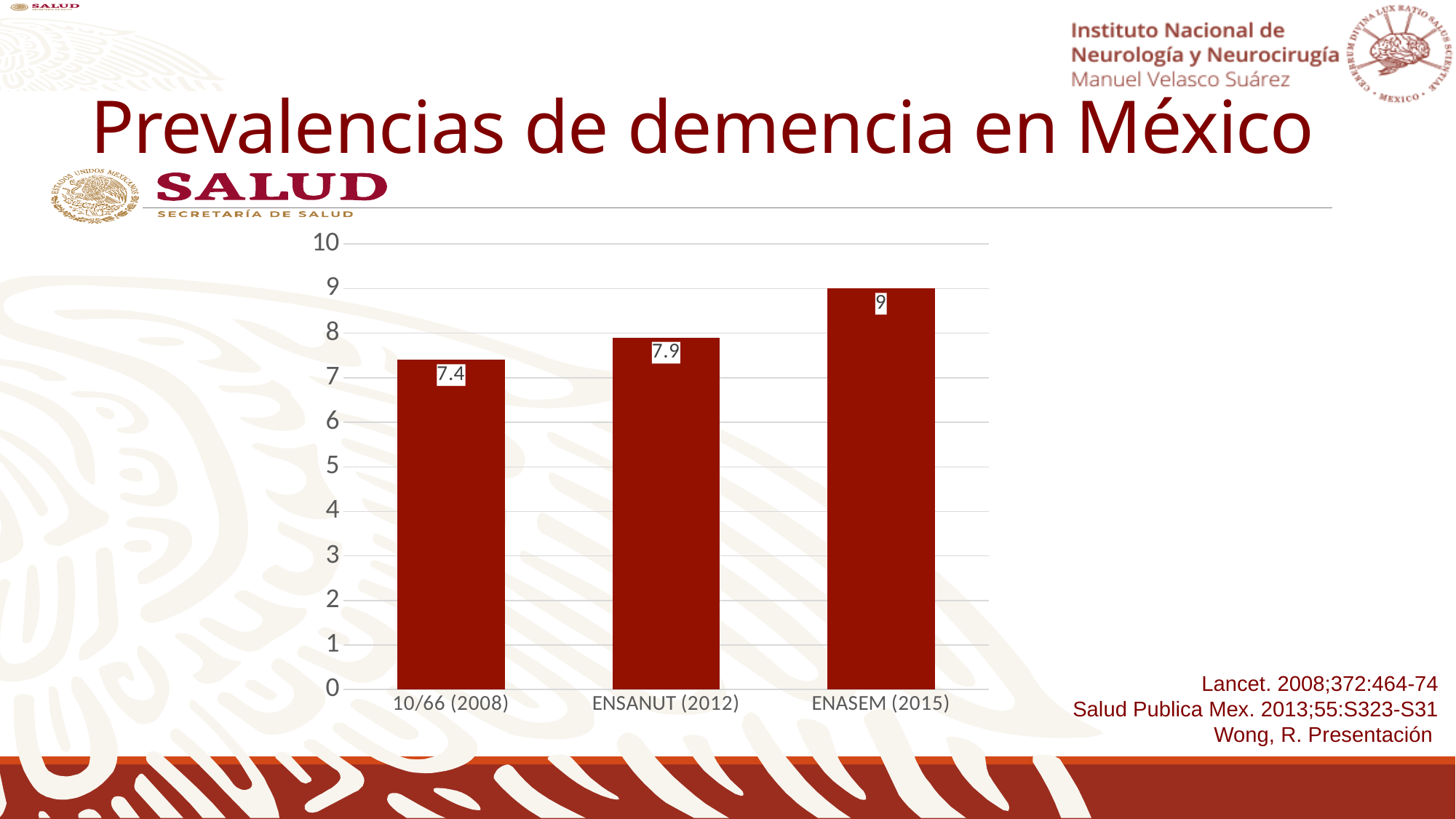
What is the value for 10/66 (2008)? 7.4 Do the values rise or fall from left to right along the x axis? rise What is the difference between the values for ENSANUT (2012) and 10/66 (2008)? 0.5 Which is larger, the value for ENSANUT (2012) or the value for ENASEM (2015)? ENASEM (2015) How many categories are shown on the x axis? 3 What is the difference between the values for ENASEM (2015) and 10/66 (2008)? 1.6 What kind of chart is shown on the slide? bar chart What is the value for ENSANUT (2012)? 7.9 Is the value for 10/66 (2008) greater or less than 8? less Which category has the highest value? ENASEM (2015) Which category has the lowest value? 10/66 (2008) What is the value for ENASEM (2015)? 9